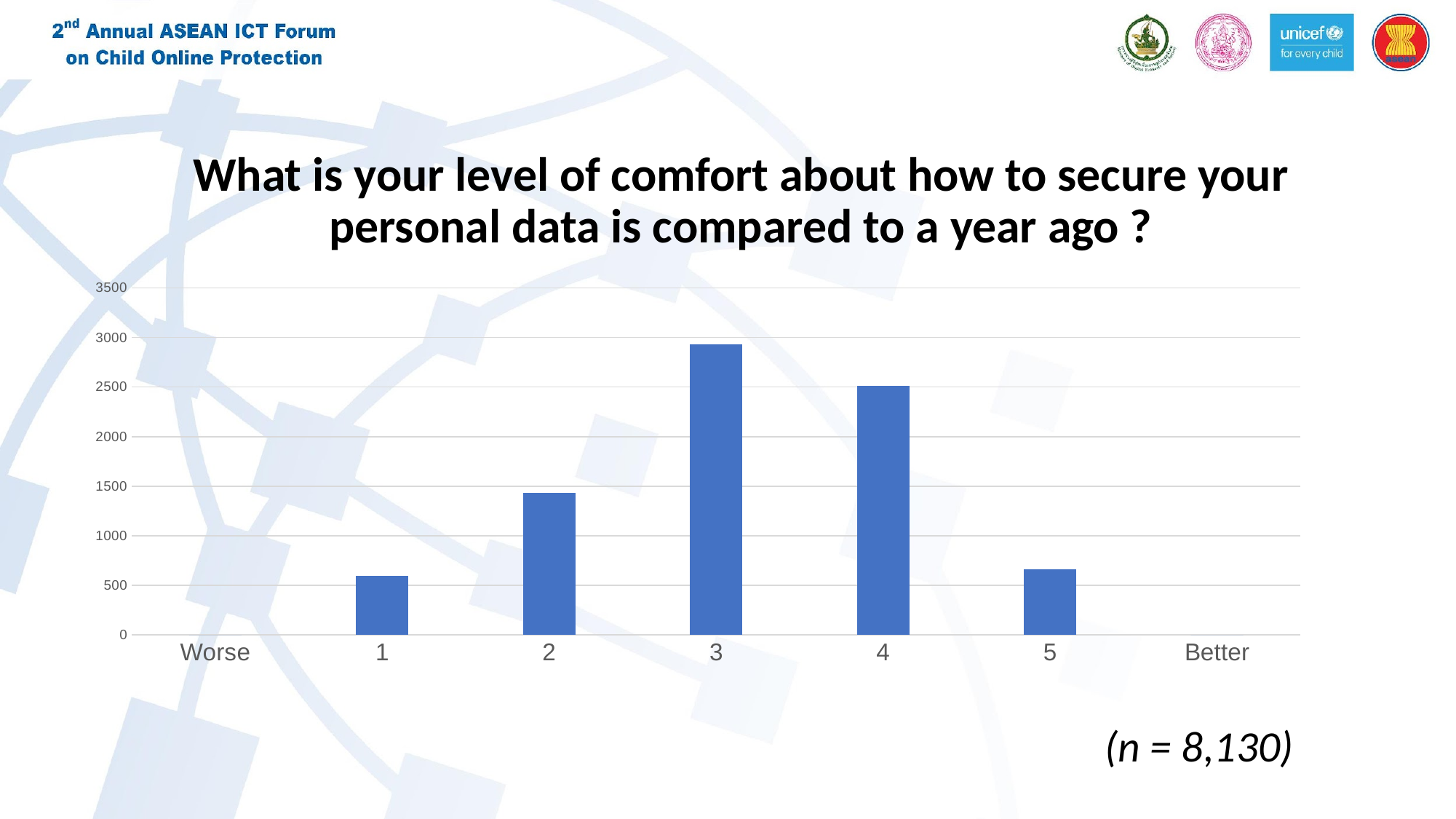
Which rating has the tallest bar? 3 What kind of chart is shown on the slide? bar chart Is the value for rating 3 greater or less than 2500? greater What is the title of the chart? What is your level of comfort about how to secure your personal data is compared to a year ago ? Is the value for rating 2 greater or less than 1500? less Which is larger, the value for rating 3 or the value for rating 4? rating 3 How many bars are plotted in the chart? 5 Is the value for rating 3 greater or less than 3000? less Which is larger, the value for rating 2 or the value for rating 5? rating 2